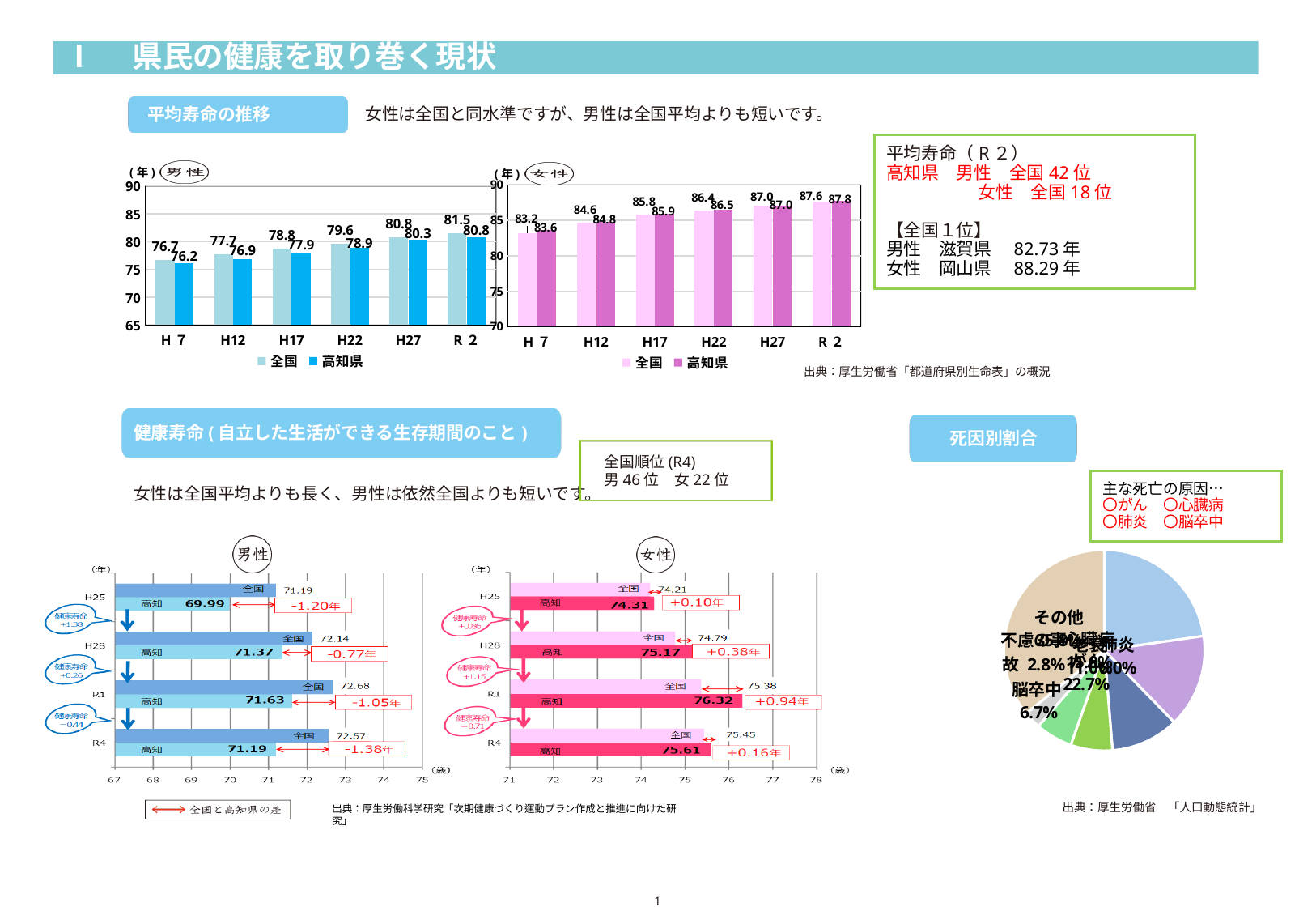
In the 平均寿命の推移 男性 bar chart, do the values for 高知県 rise or fall from H7 to R2? rise In the 平均寿命の推移 女性 bar chart, what is the difference between 高知県 and 全国 in R2? 0.2 In the 健康寿命 男性 chart, what is the value for 高知 in R4? 71.19 In the 平均寿命の推移 男性 bar chart, what is the value for 全国 in H7? 76.7 In the 平均寿命の推移 男性 bar chart, which year has the highest value for 全国? R2 In the 平均寿命の推移 男性 bar chart, what is the value for 高知県 in R2? 80.8 How many series does the legend of the 平均寿命の推移 女性 bar chart list? 2 What kind of chart is the 死因別割合 chart? pie chart In the 健康寿命 女性 chart, what is the value for 全国 in R1? 75.38 In the 健康寿命 女性 chart, which is larger in R4, 全国 or 高知? 高知 In the 平均寿命の推移 女性 bar chart, what is the value for 高知県 in H22? 86.5 How many years (categories) are shown on the x axis of the 平均寿命の推移 男性 bar chart? 6